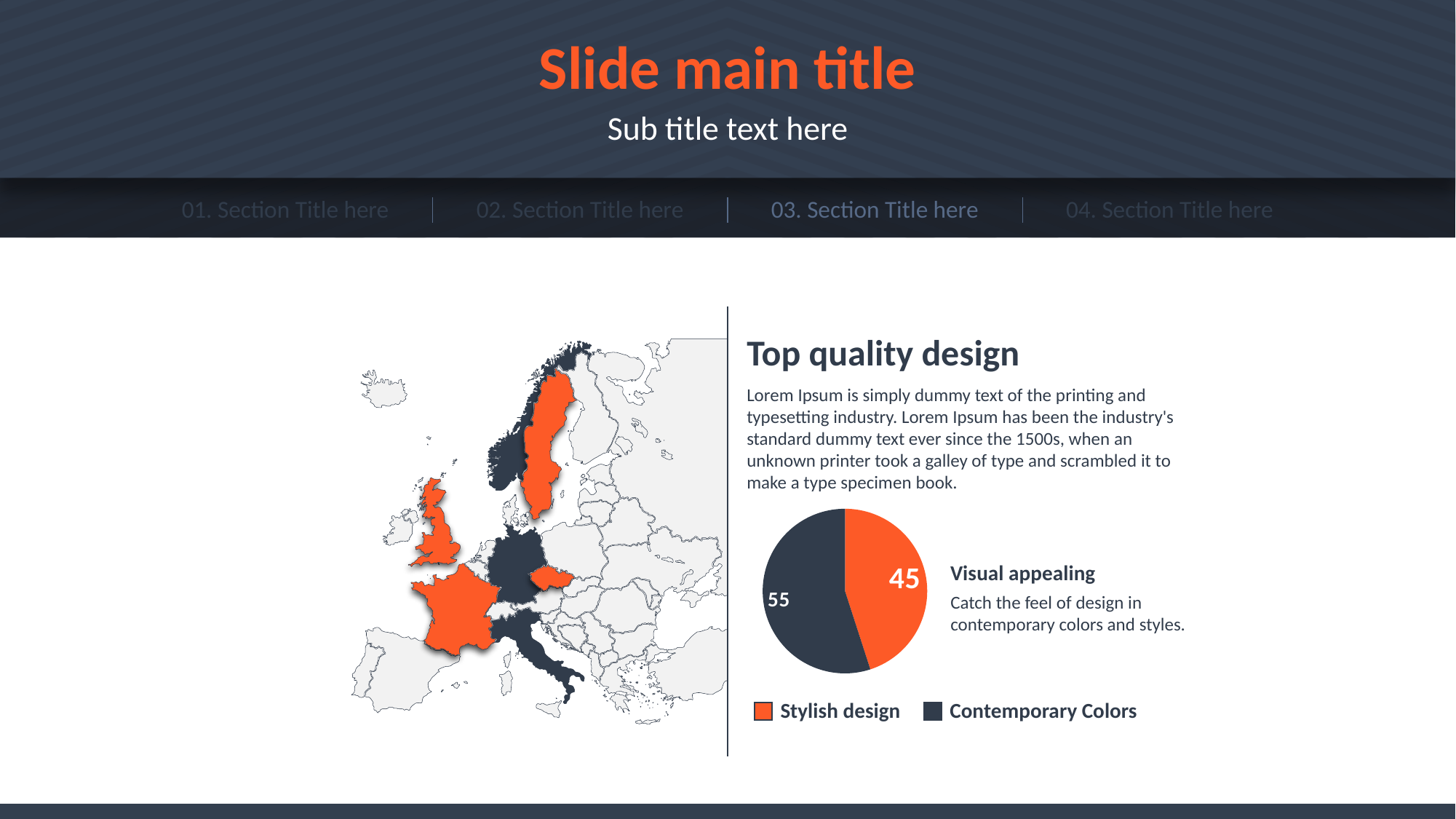
What is the total of the two values shown in the pie chart? 100 What is the value of the Contemporary Colors slice in the pie chart? 55 Which is larger in the pie chart, Stylish design or Contemporary Colors? Contemporary Colors What is the difference between the Contemporary Colors value and the Stylish design value in the pie chart? 10 What is the value of the Stylish design slice in the pie chart? 45 How many slices does the pie chart have? 2 Which slice of the pie chart is the smallest? Stylish design Which slice of the pie chart is the largest? Contemporary Colors How many entries does the pie chart's legend list? 2 What kind of chart is shown on the right side of the slide? Pie chart What share of the pie chart does the Stylish design slice represent? 45% What colour is the Stylish design slice in the pie chart? Orange